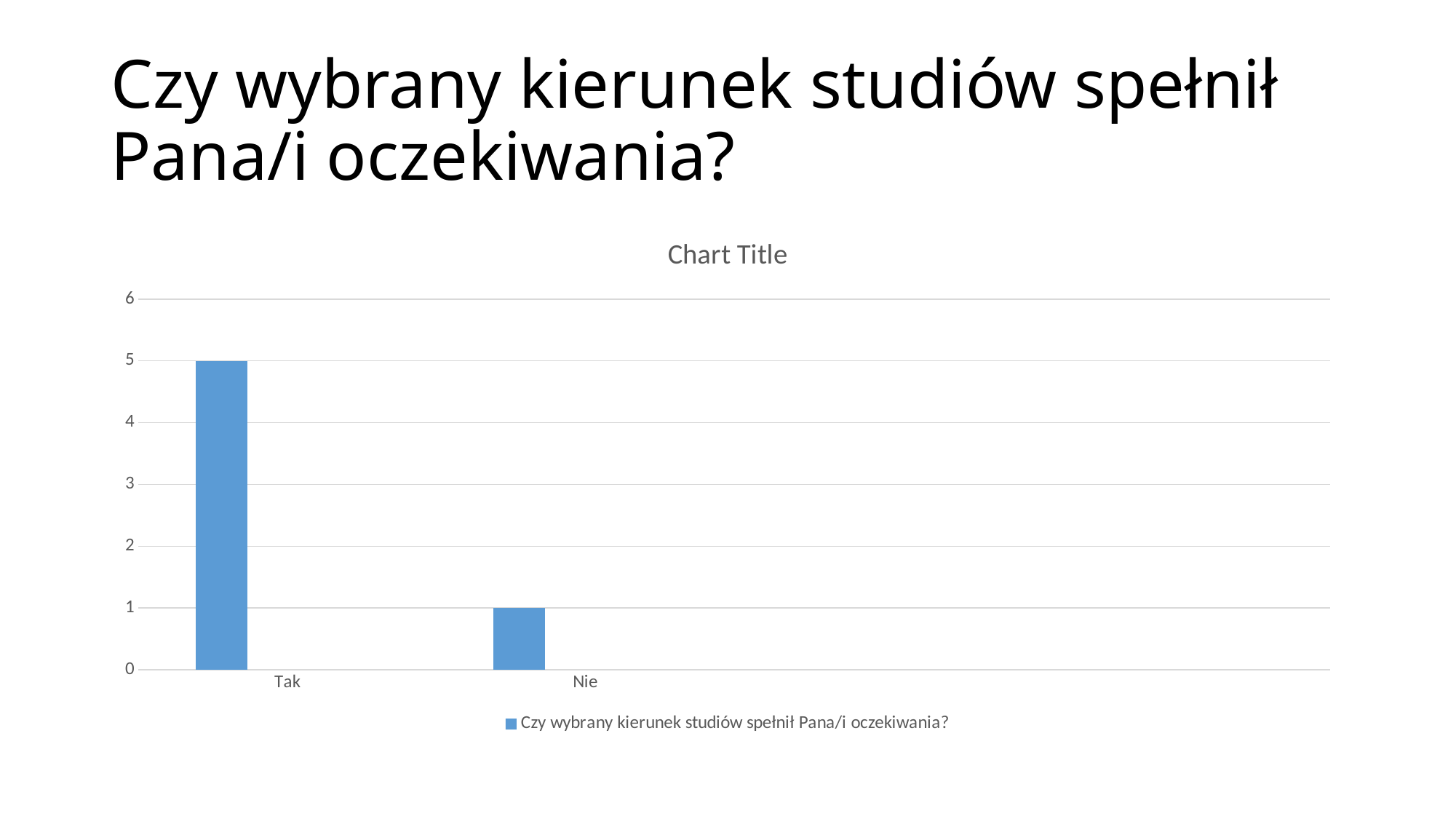
What is the value for Tak? 5 Which category has the highest value? Tak How many categories are shown on the x axis? 2 Is the value for Tak greater or less than 3? greater Which category has the lowest value? Nie What is the difference between the values for Tak and Nie? 4 What kind of chart is shown? bar chart Is the value for Nie greater or less than 2? less What is the value for Nie? 1 How many series does the legend list? 1 What is the title shown above the chart? Chart Title Which is larger, the value for Tak or the value for Nie? Tak